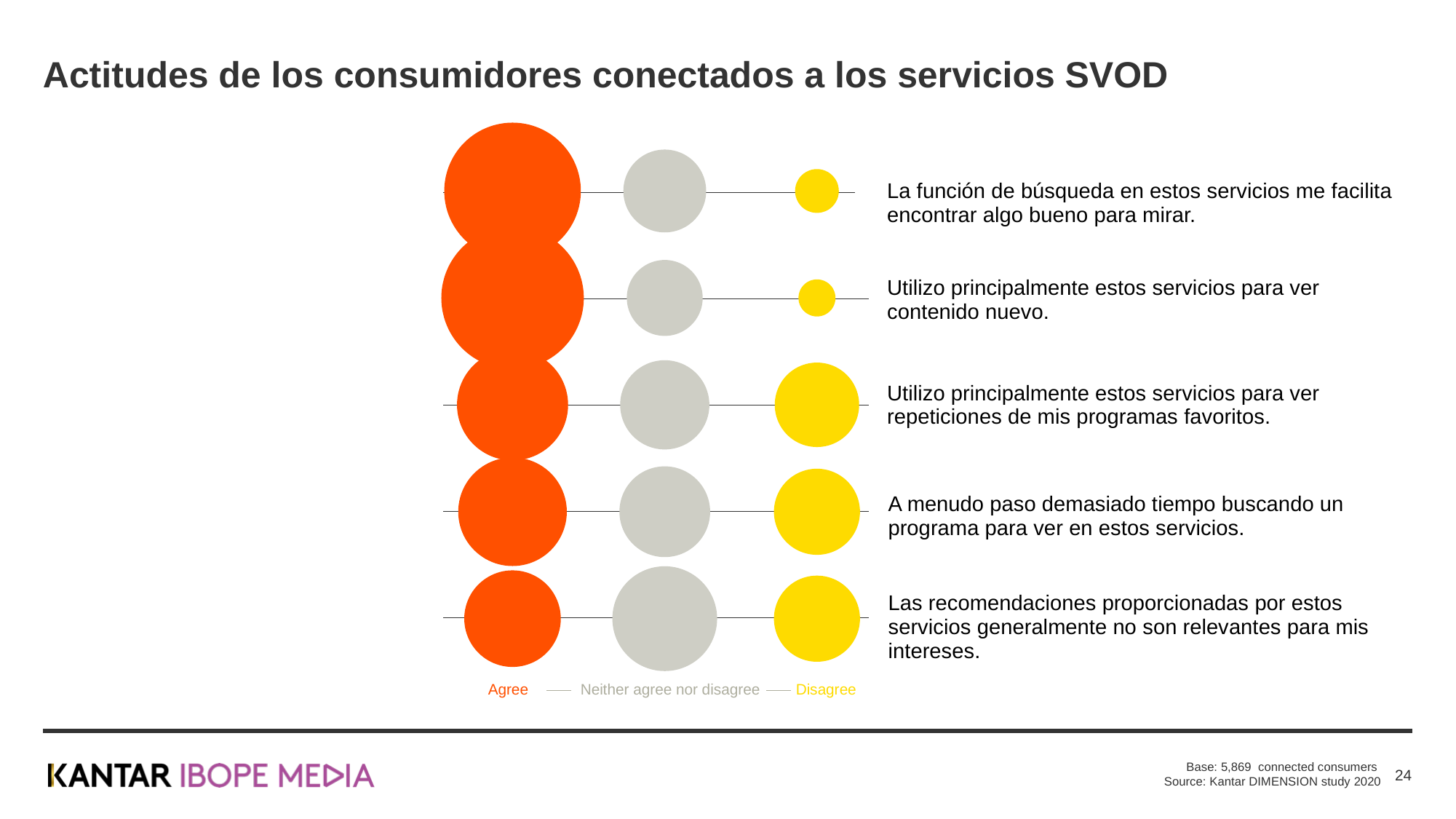
What kind of chart is shown on the slide? Bubble chart Which statement has the largest 'Neither agree nor disagree' bubble? Las recomendaciones proporcionadas por estos servicios generalmente no son relevantes para mis intereses. For 'A menudo paso demasiado tiempo buscando un programa para ver en estos servicios', which bubble is larger: Agree or Disagree? Agree What are the three legend entries of the chart? Agree, Neither agree nor disagree, Disagree How many statements (rows) are plotted in the chart? 5 Do the 'Agree' bubbles get larger or smaller going from the top statement to the bottom statement? Smaller For 'Utilizo principalmente estos servicios para ver contenido nuevo', which bubble is larger: Agree or Disagree? Agree Which statement has the largest 'Agree' bubble: 'Utilizo principalmente estos servicios para ver contenido nuevo' or 'Utilizo principalmente estos servicios para ver repeticiones de mis programas favoritos'? Utilizo principalmente estos servicios para ver contenido nuevo. Which statement has the smallest 'Agree' bubble? Las recomendaciones proporcionadas por estos servicios generalmente no son relevantes para mis intereses. Which colour represents 'Agree' in the chart? Orange How many series does the legend list? 3